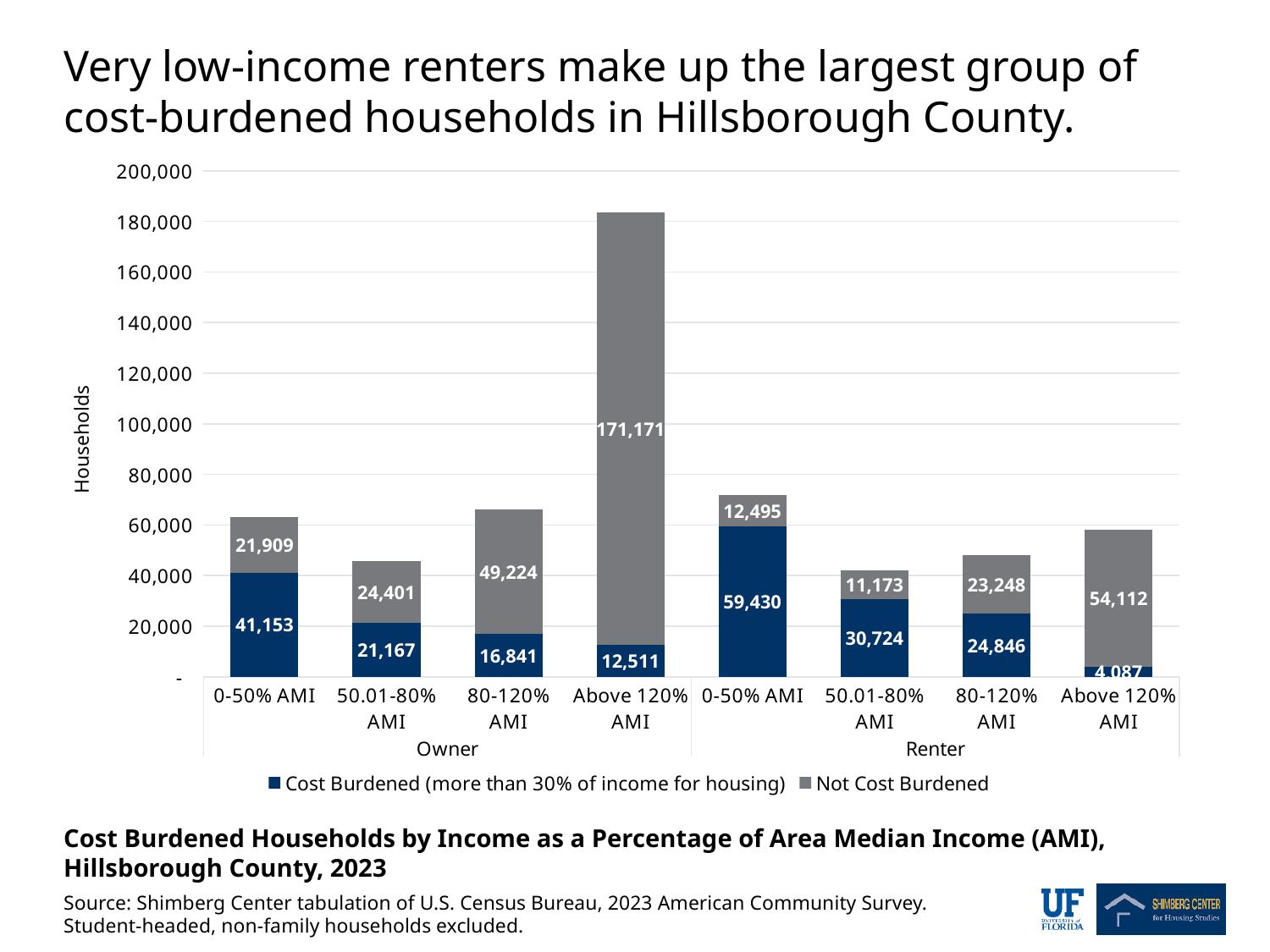
How many series does the legend list? 2 What is the total number of renter households in the 80-120% AMI group? 48,094 Is the total height of the Owner Above 120% AMI bar greater or less than 180,000? greater Which income group and tenure has the largest number of cost-burdened households? Renter, 0-50% AMI How many cost-burdened owner households are there in the 0-50% AMI group? 41,153 Which income group and tenure has the smallest number of cost-burdened households? Renter, Above 120% AMI How many income-group bars are shown in the chart across both owners and renters? 8 For owners in the 50.01-80% AMI group, which is larger: the cost-burdened or the not cost-burdened segment? Not Cost Burdened How many cost-burdened renter households are in the 0-50% AMI group? 59,430 How many more cost-burdened households are there among 0-50% AMI renters than among 0-50% AMI owners? 18,277 What is the total number of owner households in the 0-50% AMI group (cost burdened plus not cost burdened)? 63,062 What is the number of not cost-burdened owner households in the Above 120% AMI group? 171,171